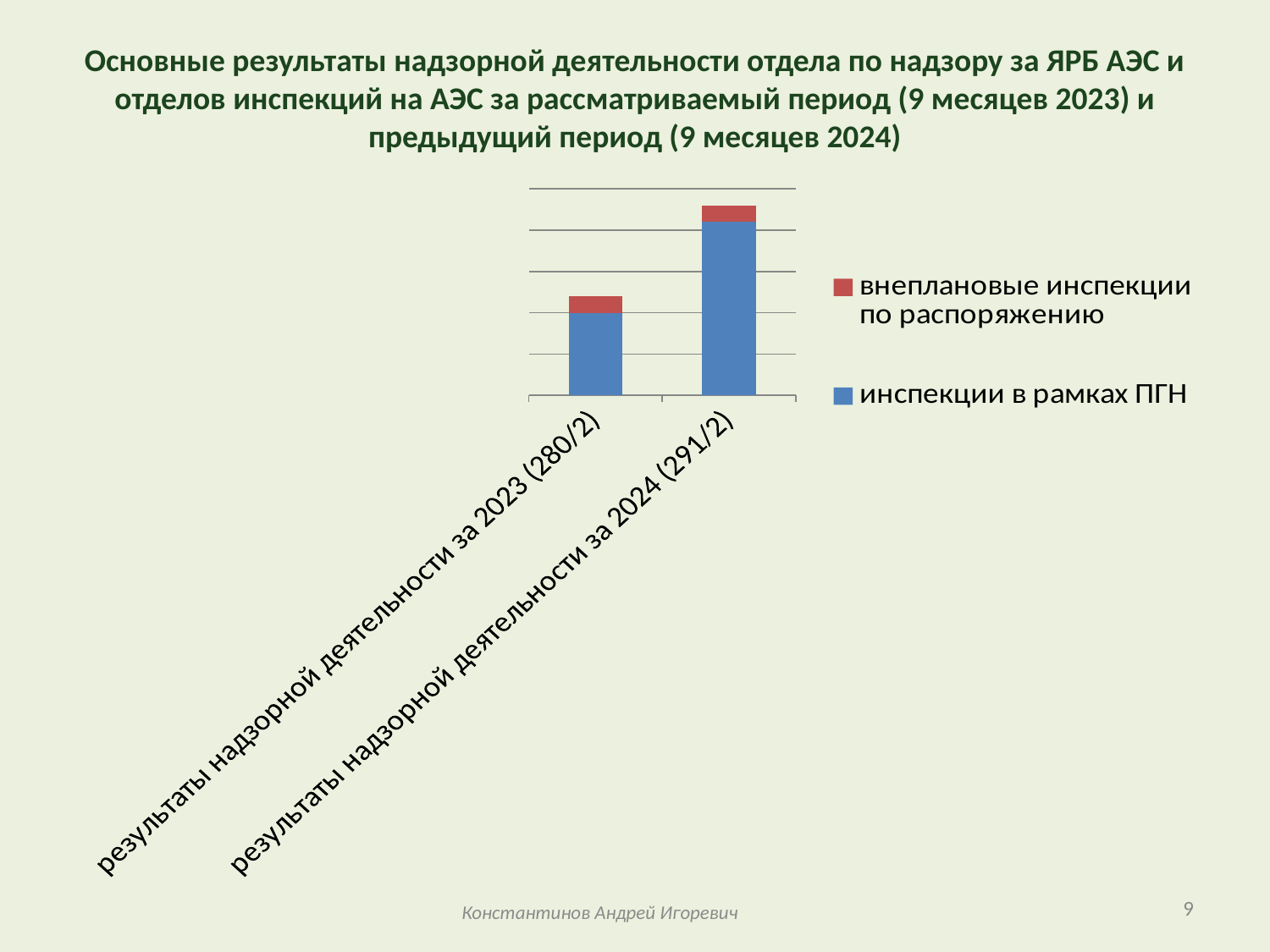
Do the stacked bar totals rise or fall from the 2023 category to the 2024 category? rise How many series does the chart's legend list? 2 Which series is shown in red in the legend? внеплановые инспекции по распоряжению Which category has the shortest stacked bar? результаты надзорной деятельности за 2023 (280/2) Which series is shown in blue in the legend? инспекции в рамках ПГН Which category has the tallest stacked bar? результаты надзорной деятельности за 2024 (291/2) Which series has the larger segment in the 2024 (291/2) bar: 'внеплановые инспекции по распоряжению' or 'инспекции в рамках ПГН'? инспекции в рамках ПГН How many categories (bars) does the chart show? 2 What kind of chart is shown on the slide? stacked bar chart Which bar is taller: the one for 2023 (280/2) or the one for 2024 (291/2)? 2024 (291/2)